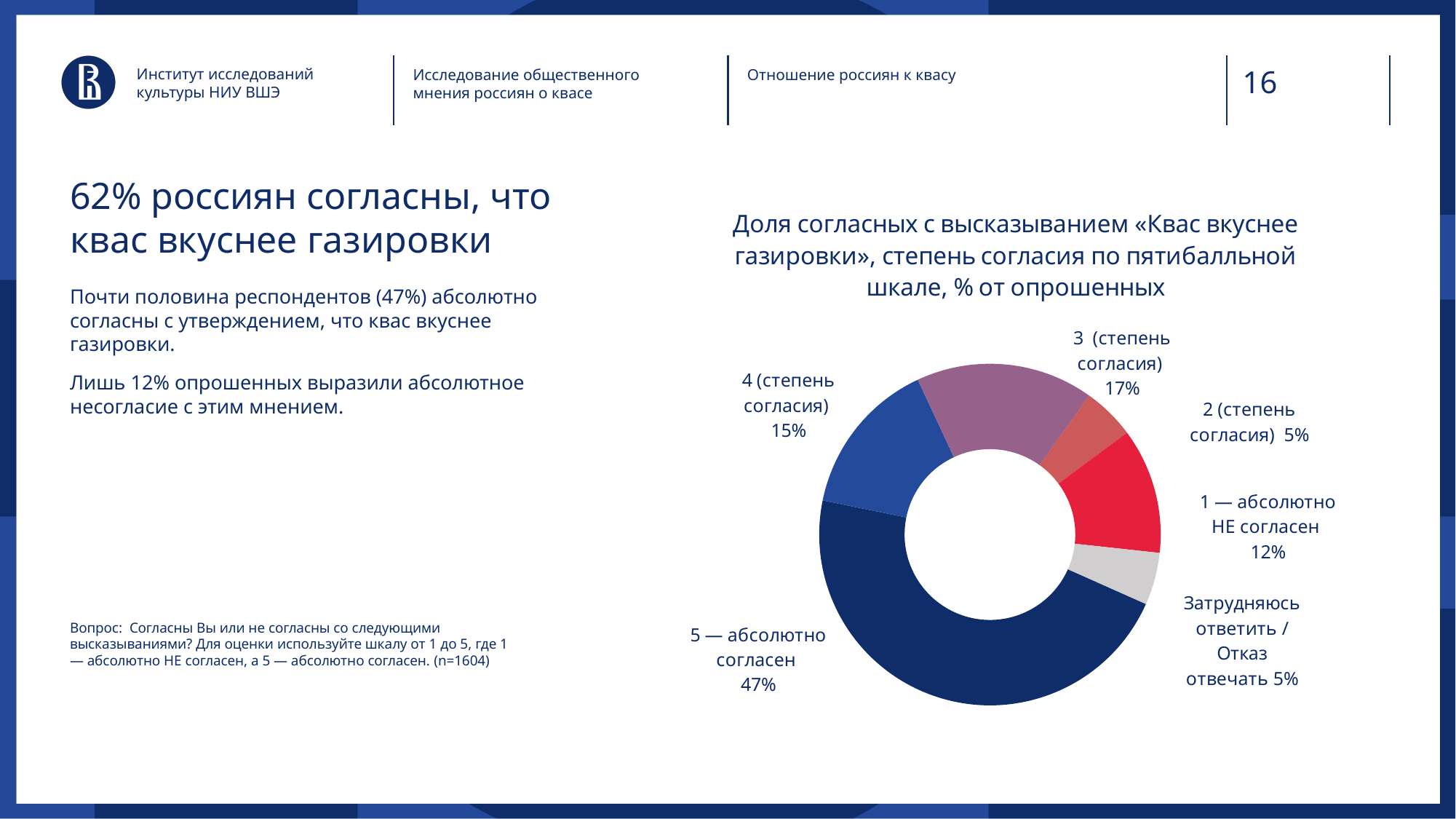
Сколько категорий (сегментов) показано на диаграмме? 6 Какова суммарная доля ответов «4 (степень согласия)» и «5 — абсолютно согласен»? 62% Какой вариант ответа имеет наибольшую долю на диаграмме? 5 — абсолютно согласен Каким цветом на диаграмме показан сегмент «1 — абсолютно НЕ согласен»? Красным Что больше: доля «3 (степень согласия)» или доля «4 (степень согласия)»? 3 (степень согласия) Какой тип диаграммы показан на слайде? Кольцевая (круговая) диаграмма Какая доля опрошенных выбрала вариант «1 — абсолютно НЕ согласен»? 12% Какая доля опрошенных выбрала «3 (степень согласия)»? 17% Какая доля опрошенных выбрала вариант «5 — абсолютно согласен»? 47% На сколько процентных пунктов доля «5 — абсолютно согласен» больше доли «1 — абсолютно НЕ согласен»? 35 Какая доля опрошенных выбрала «4 (степень согласия)»? 15% Какая доля опрошенных затруднилась ответить или отказалась отвечать? 5%